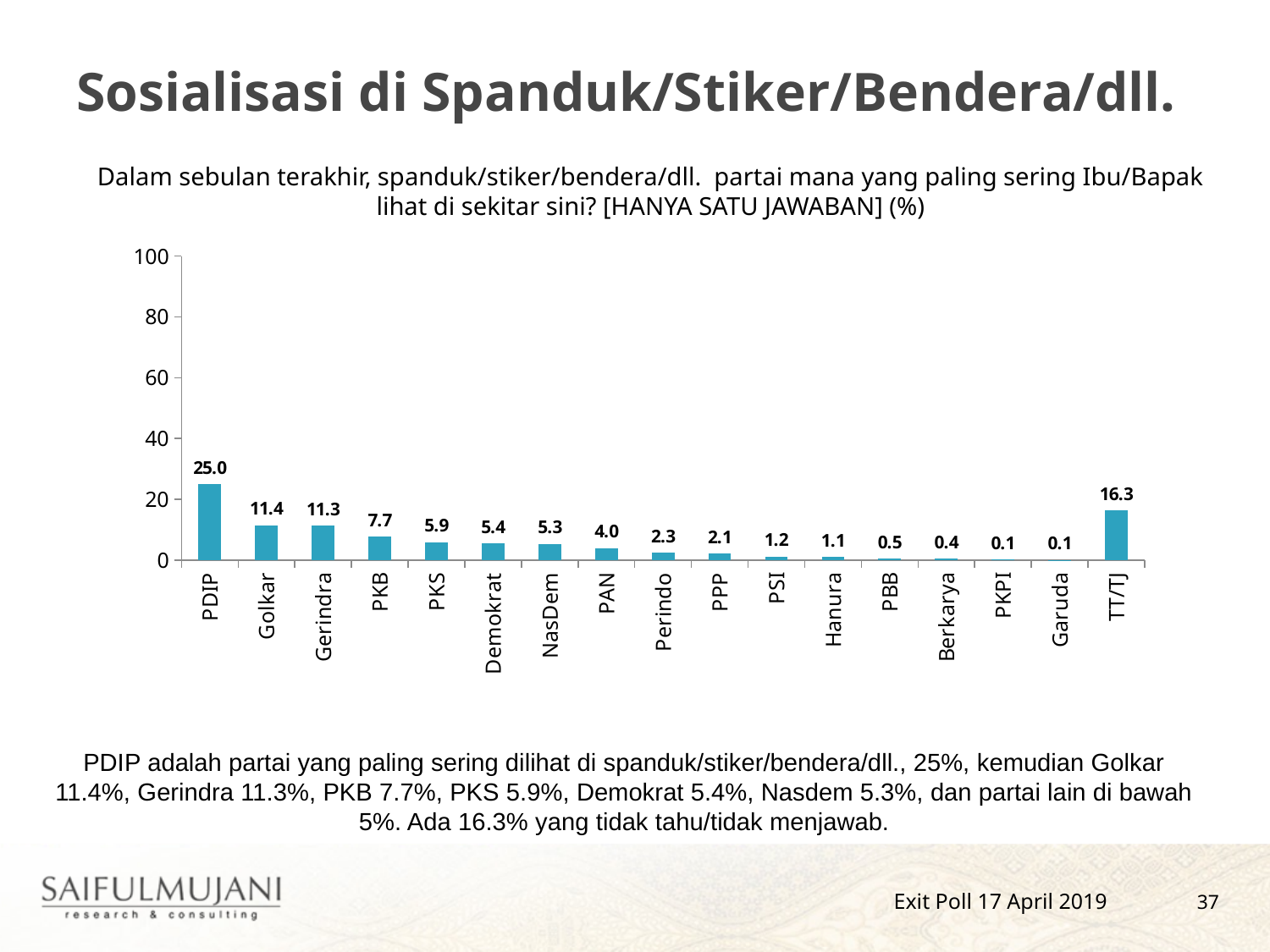
Which category has the highest value? PDIP What is the difference between the values for PKB and PKS? 1.8 What is the value for TT/TJ? 16.3 Is the value for PDIP greater or less than 20? greater What is the difference between the values for PDIP and Golkar? 13.6 What is the highest value shown on the y axis? 100 What is the value for Golkar? 11.4 What kind of chart is shown on the slide? bar chart Which is larger, the value for Gerindra or the value for TT/TJ? TT/TJ What is the value for Demokrat? 5.4 What is the value for PDIP? 25.0 How many categories are shown on the x axis? 17